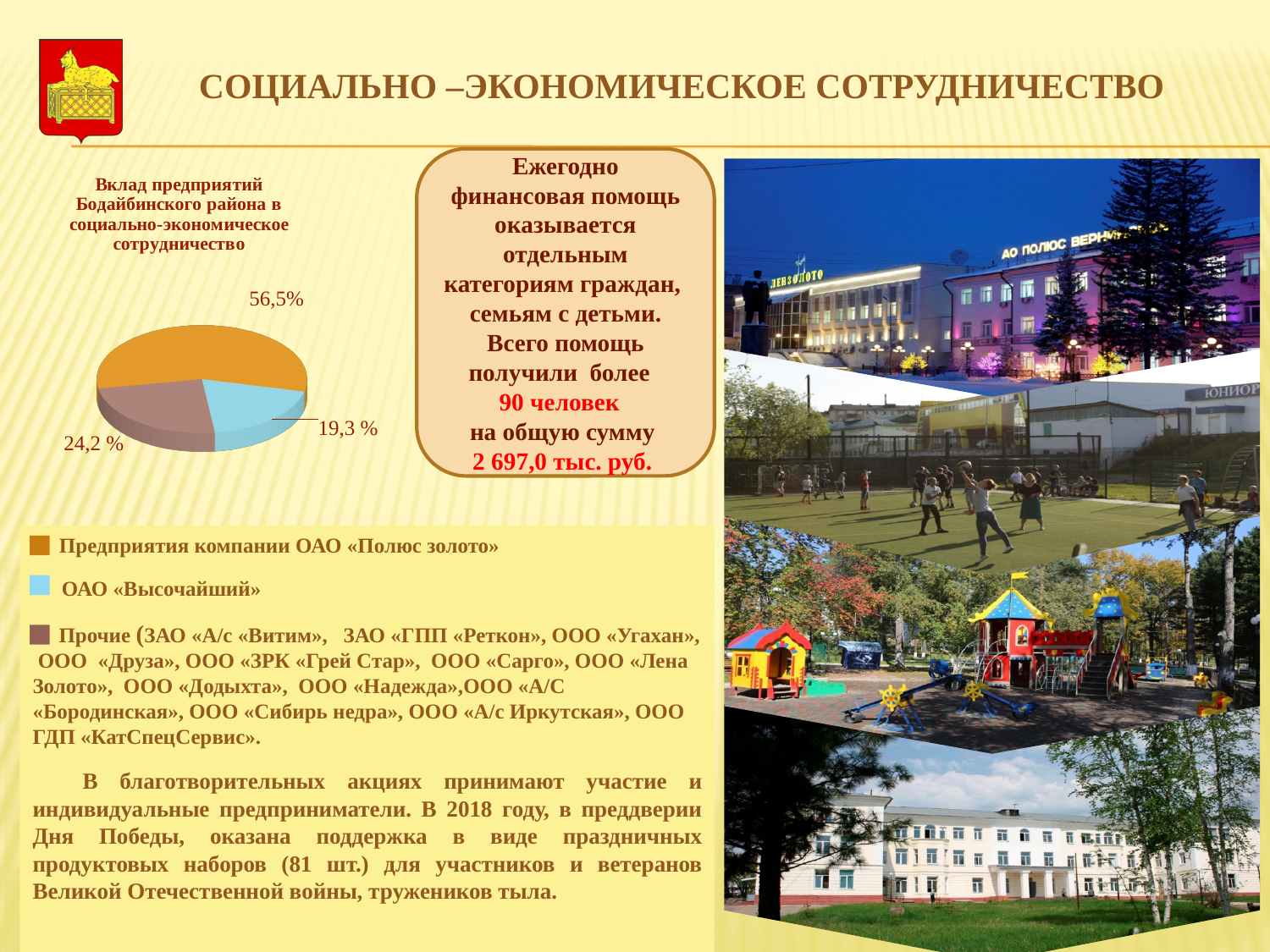
Which category has the smallest slice in the pie chart? ОАО «Высочайший» Which category has the largest slice in the pie chart? Предприятия компании ОАО «Полюс золото» What share of the pie chart belongs to Предприятия компании ОАО «Полюс золото»? 56,5% What colour is the slice for ОАО «Высочайший» in the pie chart? Light blue What share of the pie chart belongs to ОАО «Высочайший»? 19,3 % What is the difference in percentage points between the share of ОАО «Полюс золото» and the share of Прочие? 32,3 What is the title of the pie chart? Вклад предприятий Бодайбинского района в социально-экономическое сотрудничество How many slices does the pie chart have? 3 What type of chart is shown on the slide? Pie chart What is the difference in percentage points between the share of ОАО «Полюс золото» and the share of ОАО «Высочайший»? 37,2 What share of the pie chart belongs to Прочие? 24,2 % Which slice is larger: Прочие or ОАО «Высочайший»? Прочие